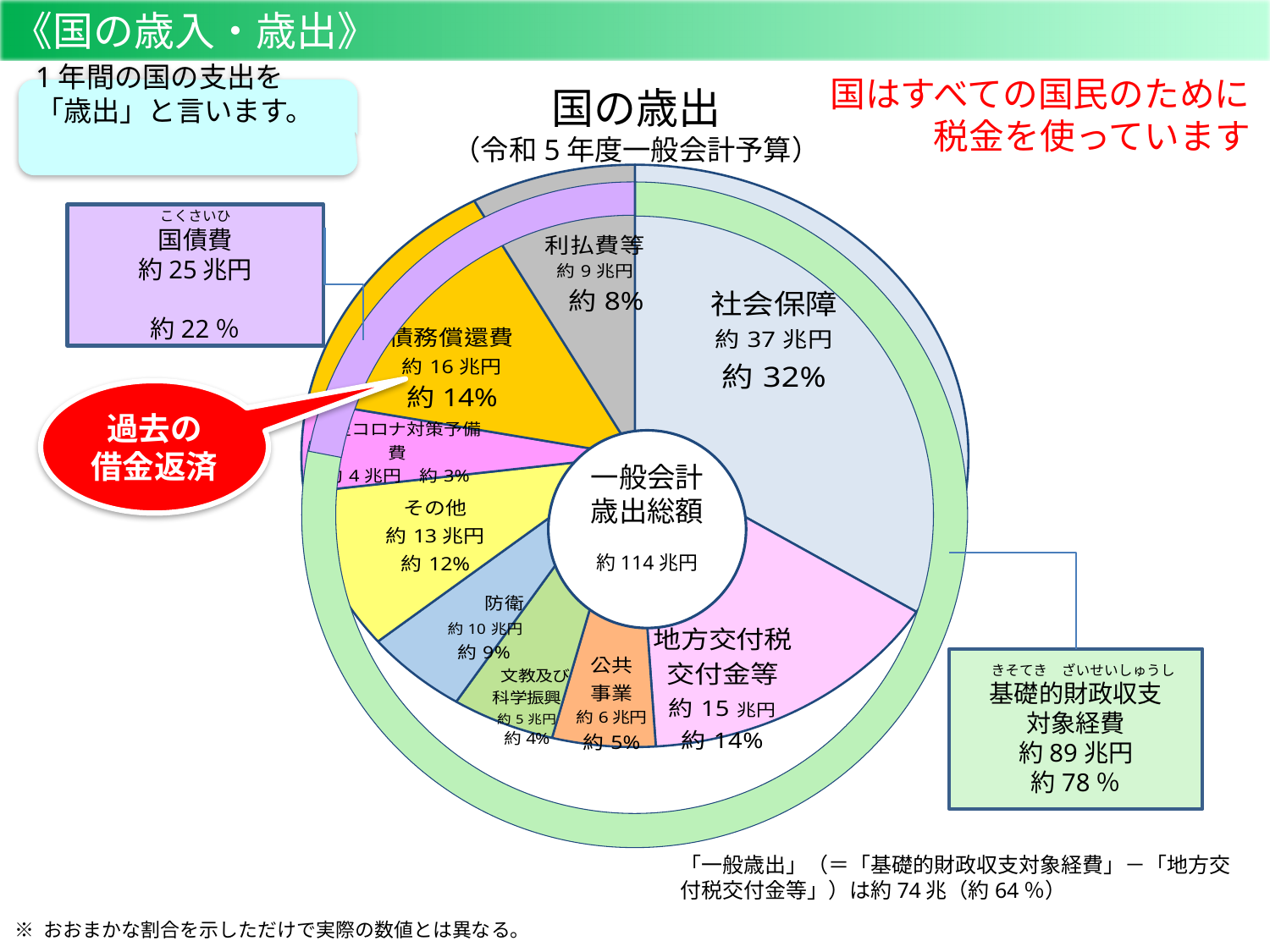
Which is larger, 防衛 or 公共事業? 防衛 What kind of chart is shown on the slide? Pie chart What is the total shown in the centre of the chart (一般会計歳出総額)? 約 114 兆円 What percentage share is shown for 債務償還費? 約 14% Which category has the smallest slice of the pie? コロナ対策予備費 What is the value shown for 地方交付税交付金等? 約 15 兆円 What is the value shown for 社会保障? 約 37 兆円 Which category has the largest slice of the pie? 社会保障 How many slices does the pie chart have? 9 What is the value shown for 防衛? 約 10 兆円 What is the title of the chart? 国の歳出（令和５年度一般会計予算） What percentage share is shown for 社会保障? 約 32%